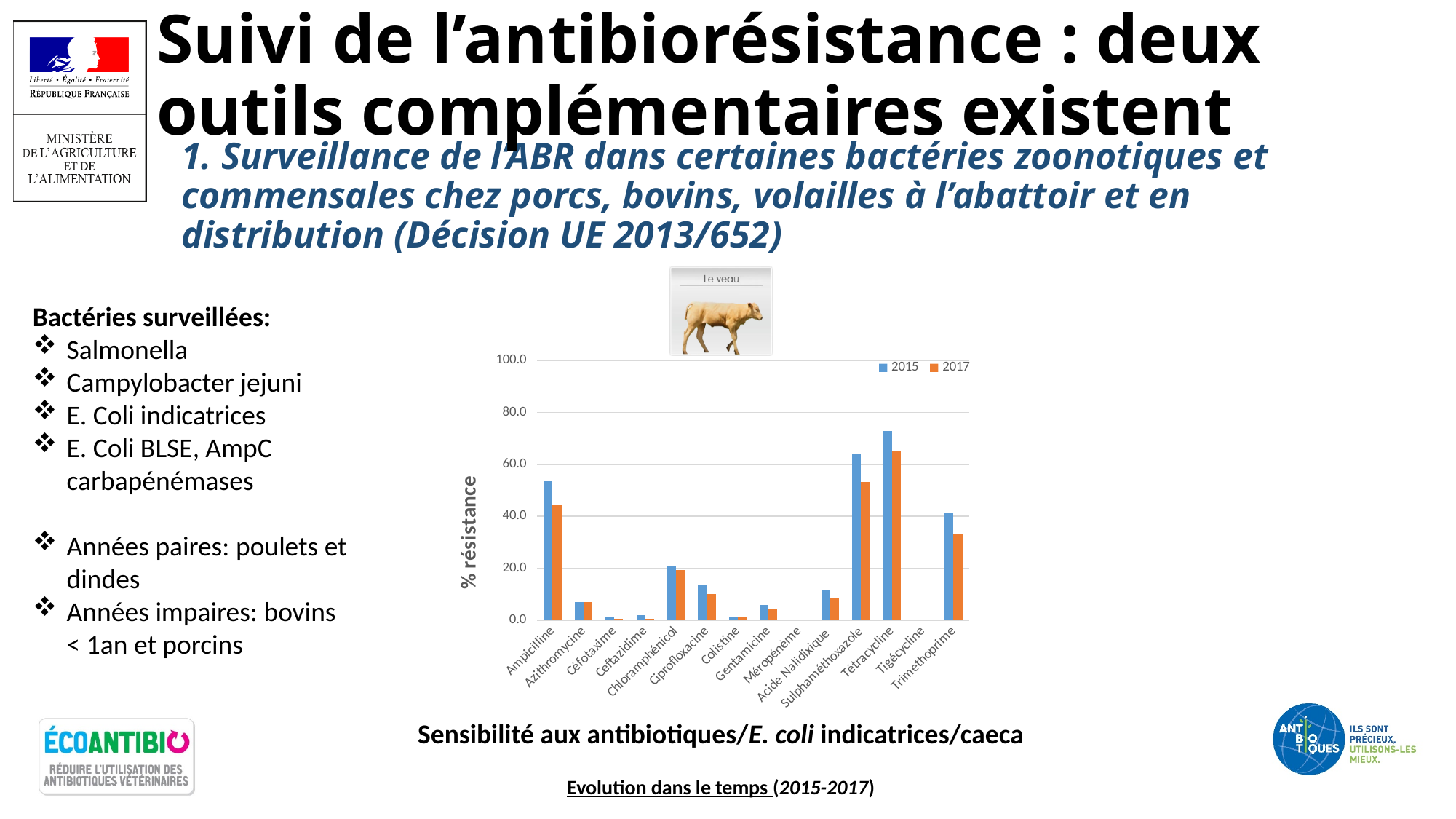
For Ampicilline, which year has the larger resistance value, 2015 or 2017? 2015 Which years are listed in the chart legend? 2015 and 2017 What is the label of the y axis of the chart? % résistance Which antibiotic has the highest resistance value for 2017? Tétracycline What kind of chart is shown on the slide? bar chart How many antibiotic categories are shown on the x axis of the chart? 14 Is the 2017 value for Trimethoprime greater or less than 40.0? less Which antibiotic has the highest resistance value for 2015? Tétracycline How many series does the chart legend list? 2 Is the 2015 value for Ampicilline greater or less than 40.0? greater For 2015, which is larger, the value for Sulphaméthoxazole or the value for Tétracycline? Tétracycline Is the 2015 value for Tétracycline greater or less than 60.0? greater